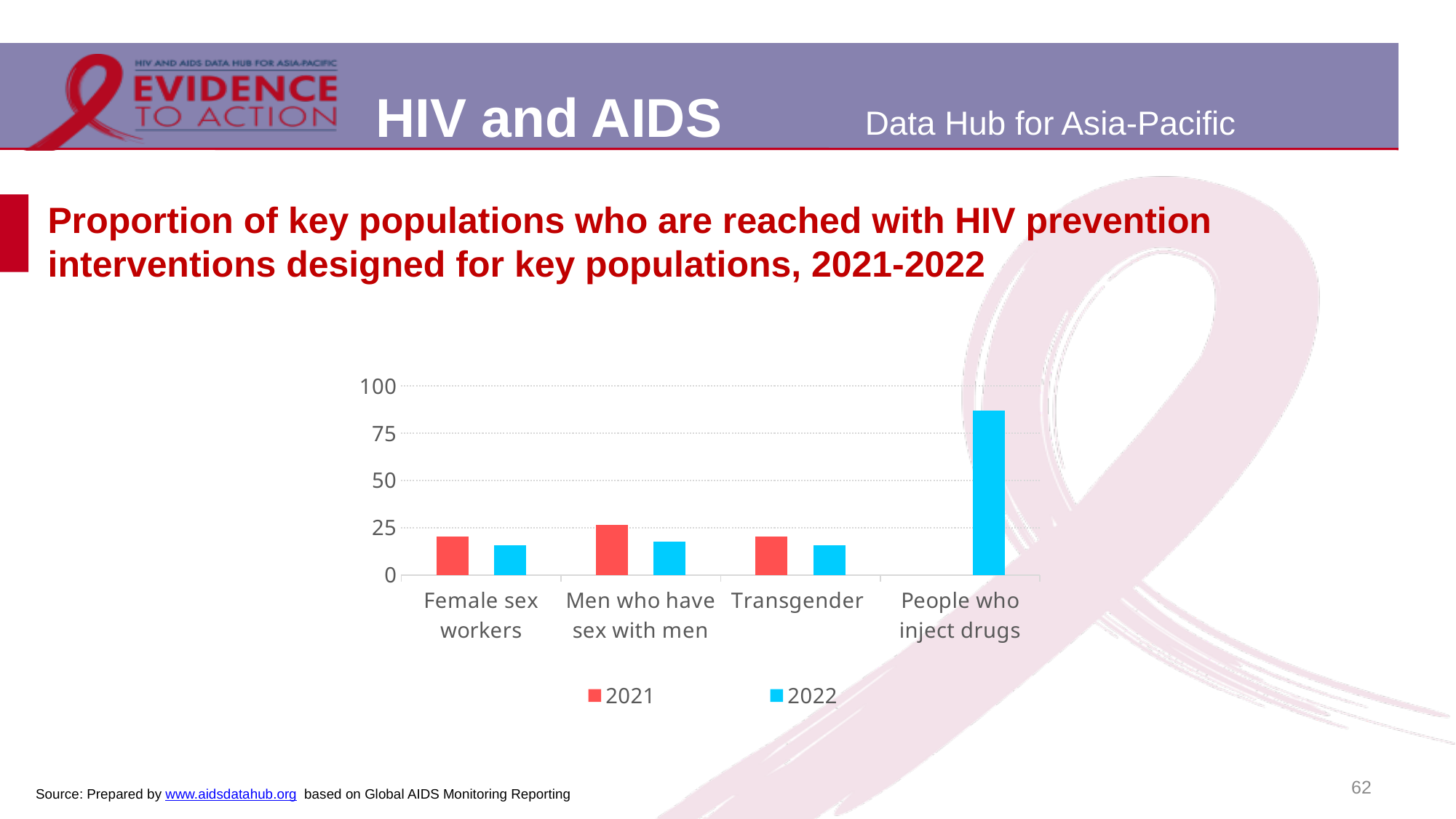
What colour represents the 2022 series in the legend? blue Which category has the highest value for 2021? Men who have sex with men For Men who have sex with men, which year has the larger value, 2021 or 2022? 2021 What kind of chart is shown on the slide? bar chart Which category has the highest value for 2022? People who inject drugs Is the 2021 value for Female sex workers greater or less than 25? less How many series does the legend list? 2 Is the 2022 value for People who inject drugs greater or less than 75? greater Is the 2022 value for Transgender greater or less than 25? less Which category has no bar shown for 2021? People who inject drugs How many key population categories are shown on the x axis? 4